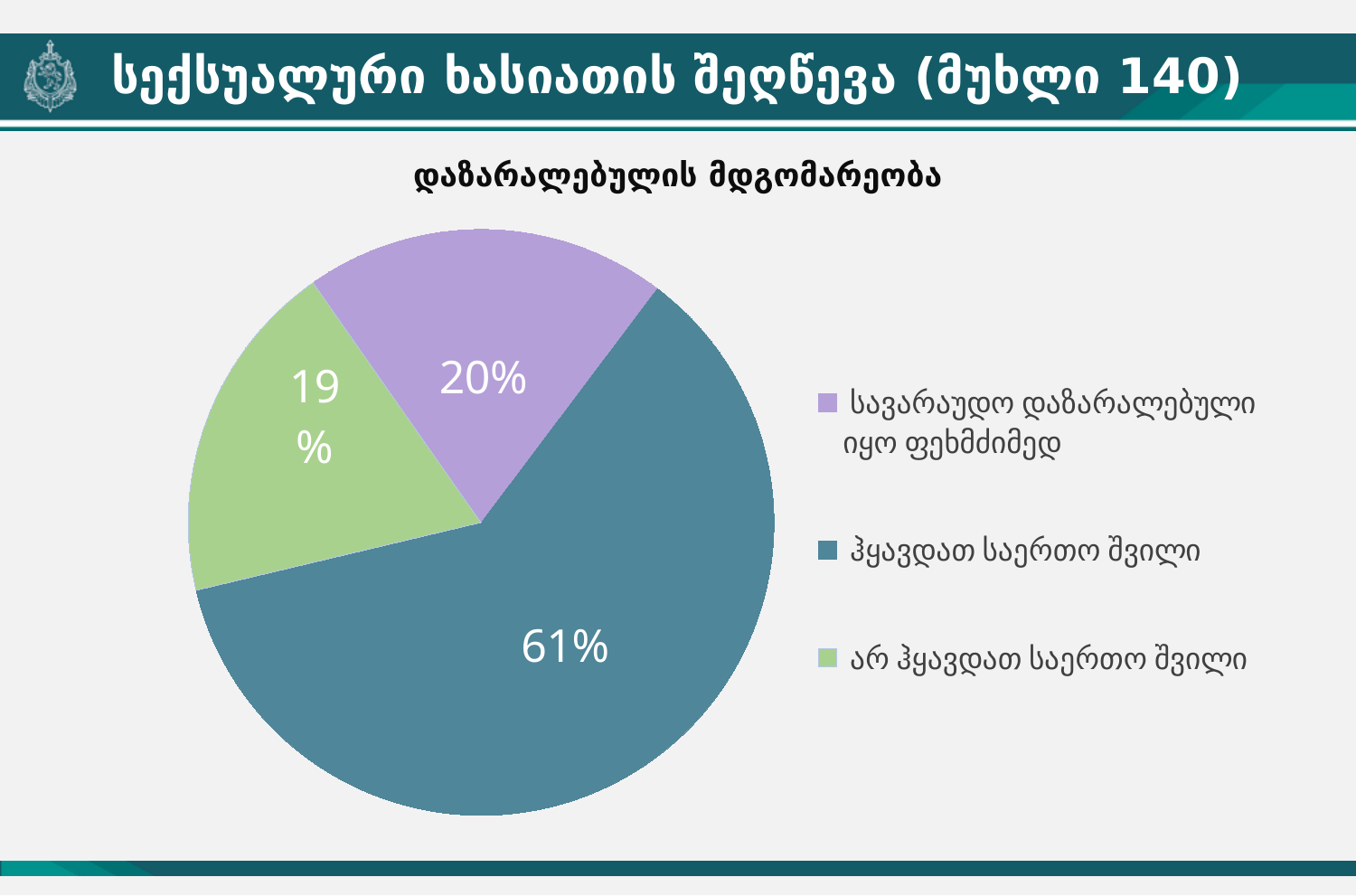
What kind of chart is shown on the slide? pie chart What is the title of the chart? დაზარალებულის მდგომარეობა Which category has the smallest slice of the pie? არ ჰყავდათ საერთო შვილი Which is larger: the share for "სავარაუდო დაზარალებული იყო ფეხმძიმედ" or the share for "არ ჰყავდათ საერთო შვილი"? სავარაუდო დაზარალებული იყო ფეხმძიმედ What share of the pie does "არ ჰყავდათ საერთო შვილი" take? 19% What share of the pie does "ჰყავდათ საერთო შვილი" take? 61% Which category has the largest slice of the pie? ჰყავდათ საერთო შვილი How many entries does the legend list? 3 What colour is the slice for "არ ჰყავდათ საერთო შვილი"? green What is the difference between the share for "ჰყავდათ საერთო შვილი" and the share for "სავარაუდო დაზარალებული იყო ფეხმძიმედ"? 41% What share of the pie does "სავარაუდო დაზარალებული იყო ფეხმძიმედ" take? 20% How many slices does the pie chart have? 3